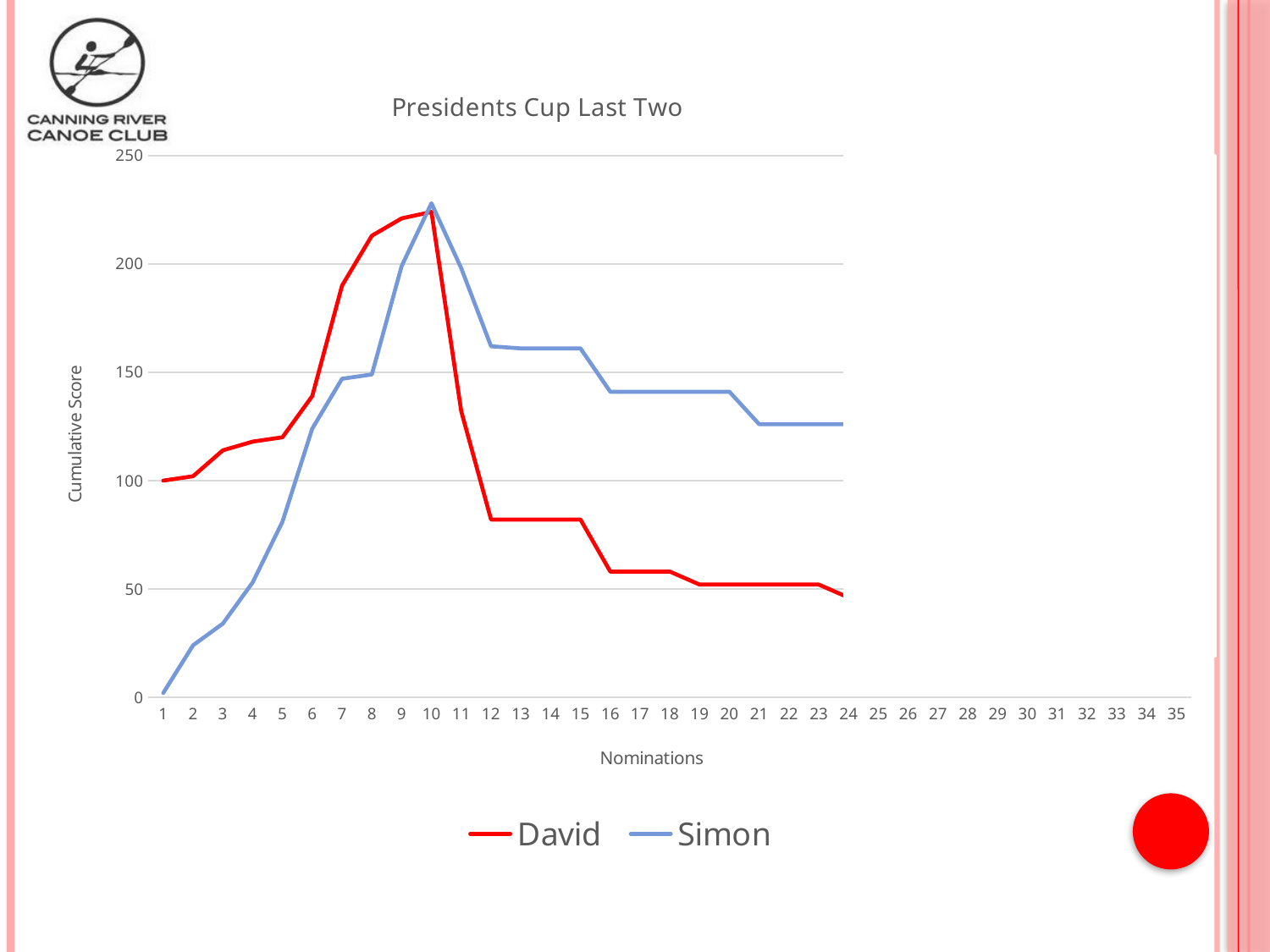
Is Simon's cumulative score at nomination 5 greater or less than 100? less At nomination 20, who has the higher cumulative score, David or Simon? Simon Is David's cumulative score at nomination 8 greater or less than 200? greater At nomination 5, who has the higher cumulative score, David or Simon? David What kind of chart is shown on the slide? line chart Does David's cumulative score rise or fall from nomination 12 to nomination 24? fall How many series does the legend list? 2 How many nominations are labelled along the x axis? 35 What is the title of the chart? Presidents Cup Last Two Is Simon's cumulative score at nomination 24 greater or less than 100? greater What is the label on the vertical axis? Cumulative Score